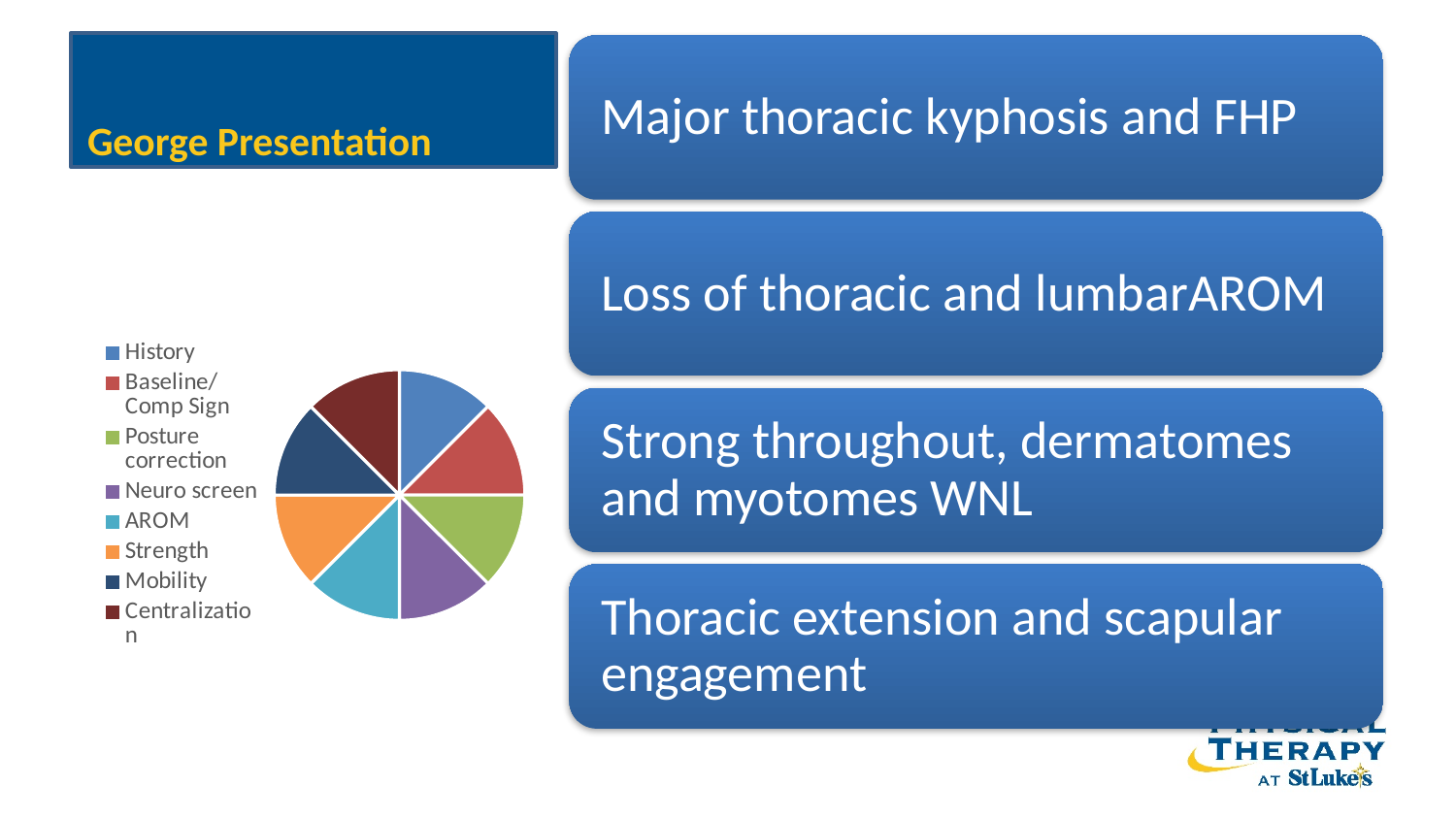
What kind of chart is shown on the left of the slide? Pie chart Which legend entry of the pie chart is shown in orange? Strength Is 'AROM' one of the categories in the pie chart? Yes Is 'Neuro screen' one of the categories in the pie chart? Yes Which legend entry is listed last in the pie chart's legend? Centralization How many entries does the pie chart's legend list? 8 How many slices does the pie chart have? 8 What colour is the History slice in the pie chart? Blue Do the slices of the pie chart appear equal in size or do they differ noticeably? Equal Which legend entry is listed first in the pie chart's legend? History